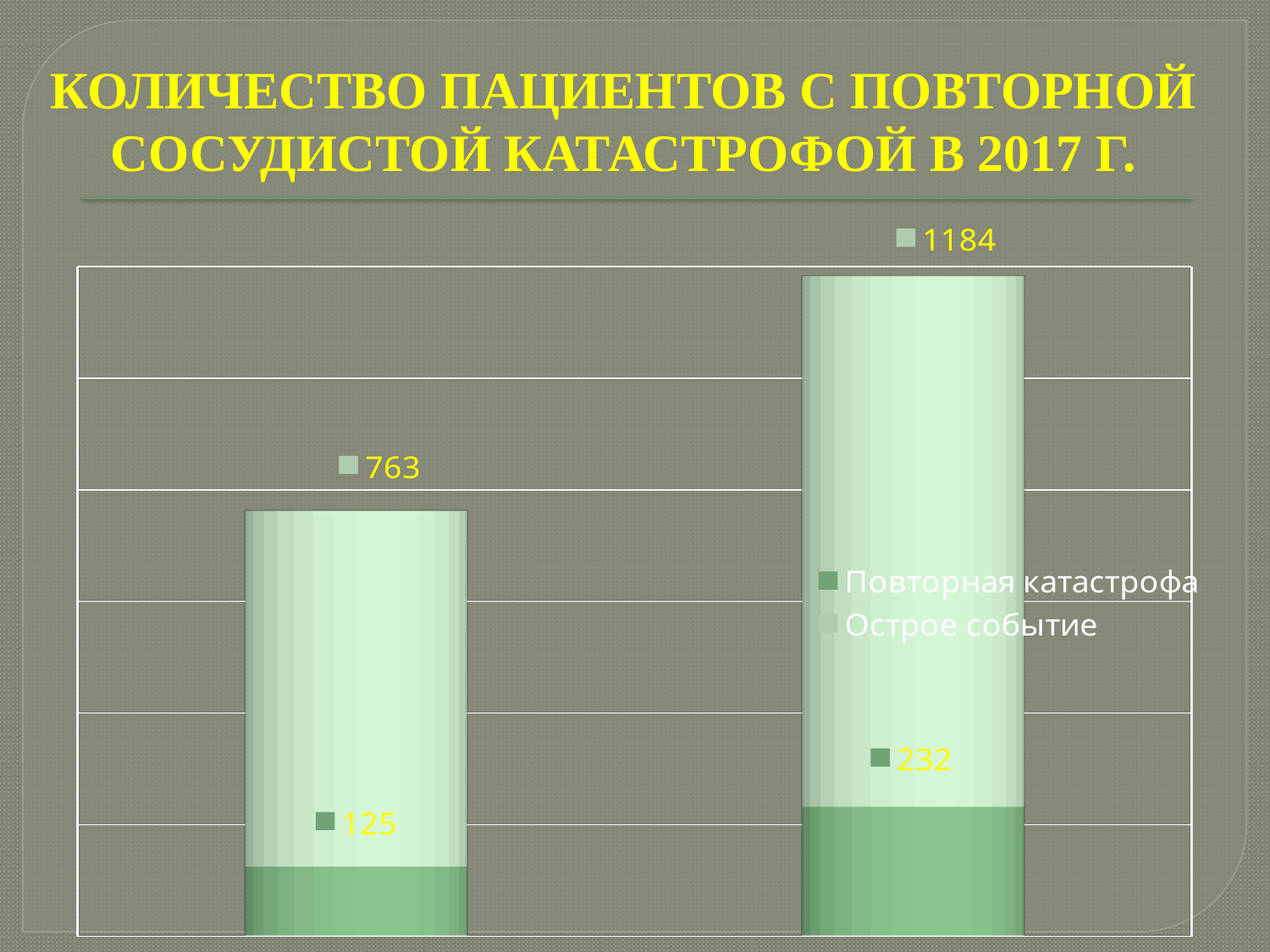
What is the difference between the "Острое событие" values of the right bar and the left bar? 421 Which bar has the larger "Повторная катастрофа" value, the left or the right? right What kind of chart is shown on the slide? bar chart What is the value of the "Острое событие" segment in the left bar? 763 What is the difference between the "Повторная катастрофа" values of the right bar and the left bar? 107 What is the value of the "Острое событие" segment in the right bar? 1184 How many series does the legend list? 2 What is the value of the "Повторная катастрофа" segment in the right bar? 232 Which legend entry is shown in the darker green colour? Повторная катастрофа What is the total of the left stacked bar? 888 How many stacked bars are plotted in the chart? 2 What is the value of the "Повторная катастрофа" segment in the left bar? 125